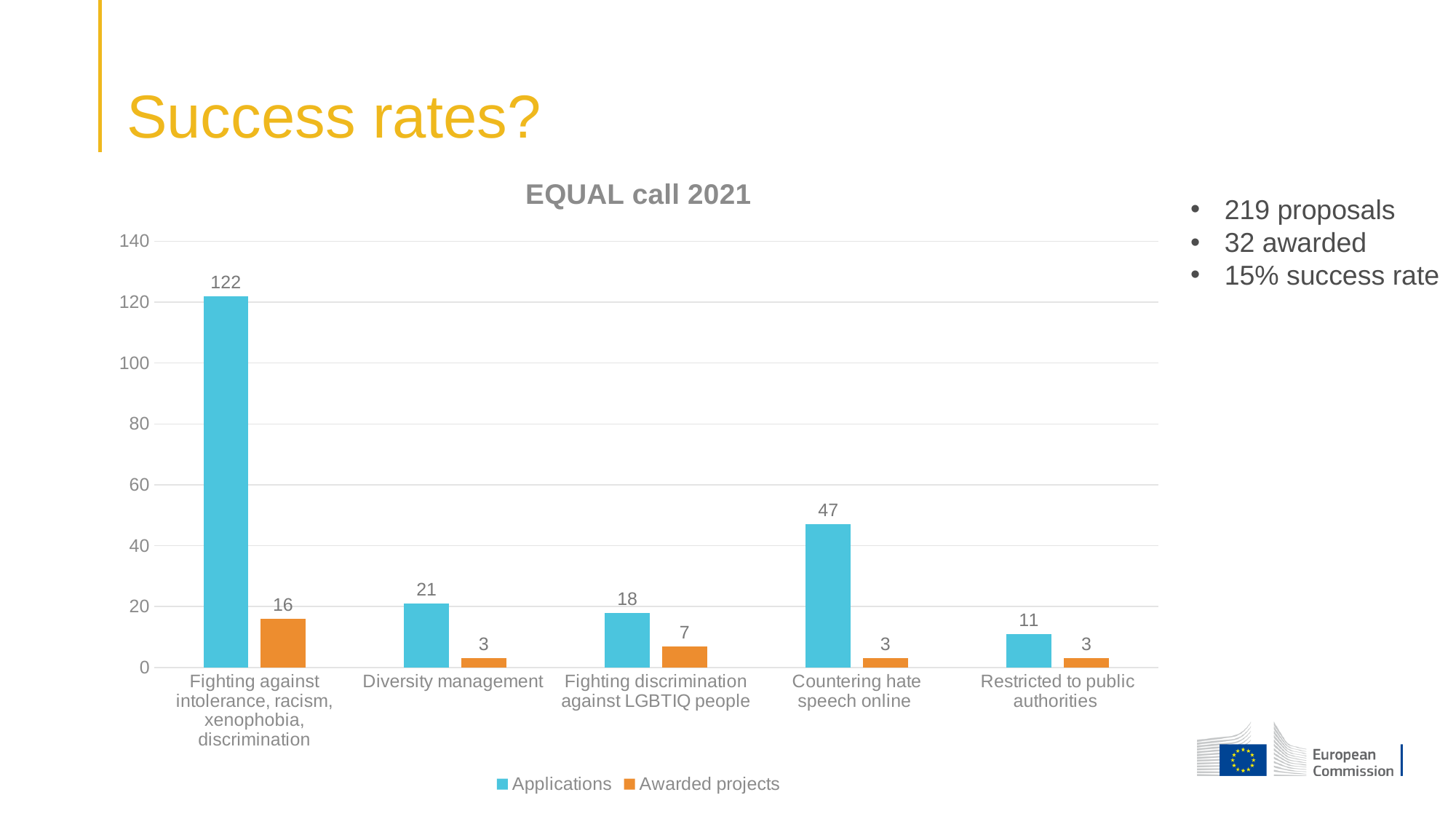
What is the title of the chart? EQUAL call 2021 Which category has the highest number of Applications? Fighting against intolerance, racism, xenophobia, discrimination Is the number of Applications for Countering hate speech online greater or less than 40? greater What kind of chart is shown on the slide? bar chart How many Applications were there for Restricted to public authorities? 11 Which has more Applications, Diversity management or Fighting discrimination against LGBTIQ people? Diversity management How many Applications were there for Countering hate speech online? 47 What is the difference between Applications and Awarded projects for Fighting against intolerance, racism, xenophobia, discrimination? 106 How many Awarded projects were there for Fighting discrimination against LGBTIQ people? 7 How many series does the legend list? 2 How many categories are shown on the x axis? 5 Which category has the lowest number of Applications? Restricted to public authorities